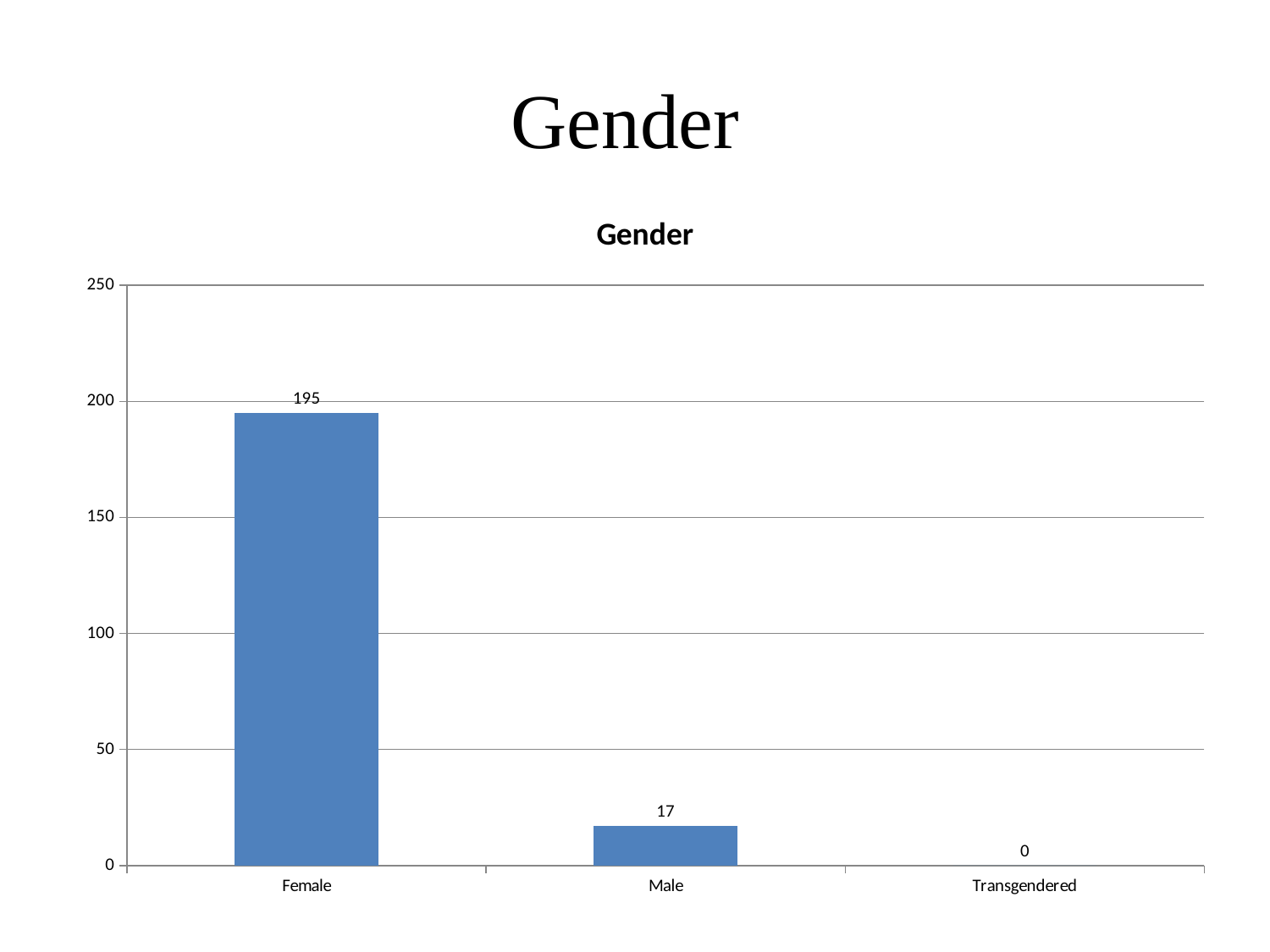
How many categories are shown on the x axis? 3 Is the value for Male greater or less than 50? less What is the difference between the values for Female and Male? 178 Which category has the highest value? Female Which category has the lowest value? Transgendered What is the value for Transgendered? 0 What kind of chart is shown? bar chart Is the value for Female greater or less than 150? greater What is the title of the chart? Gender Which is larger, the value for Male or the value for Transgendered? Male What is the value for Male? 17 What is the value for Female? 195